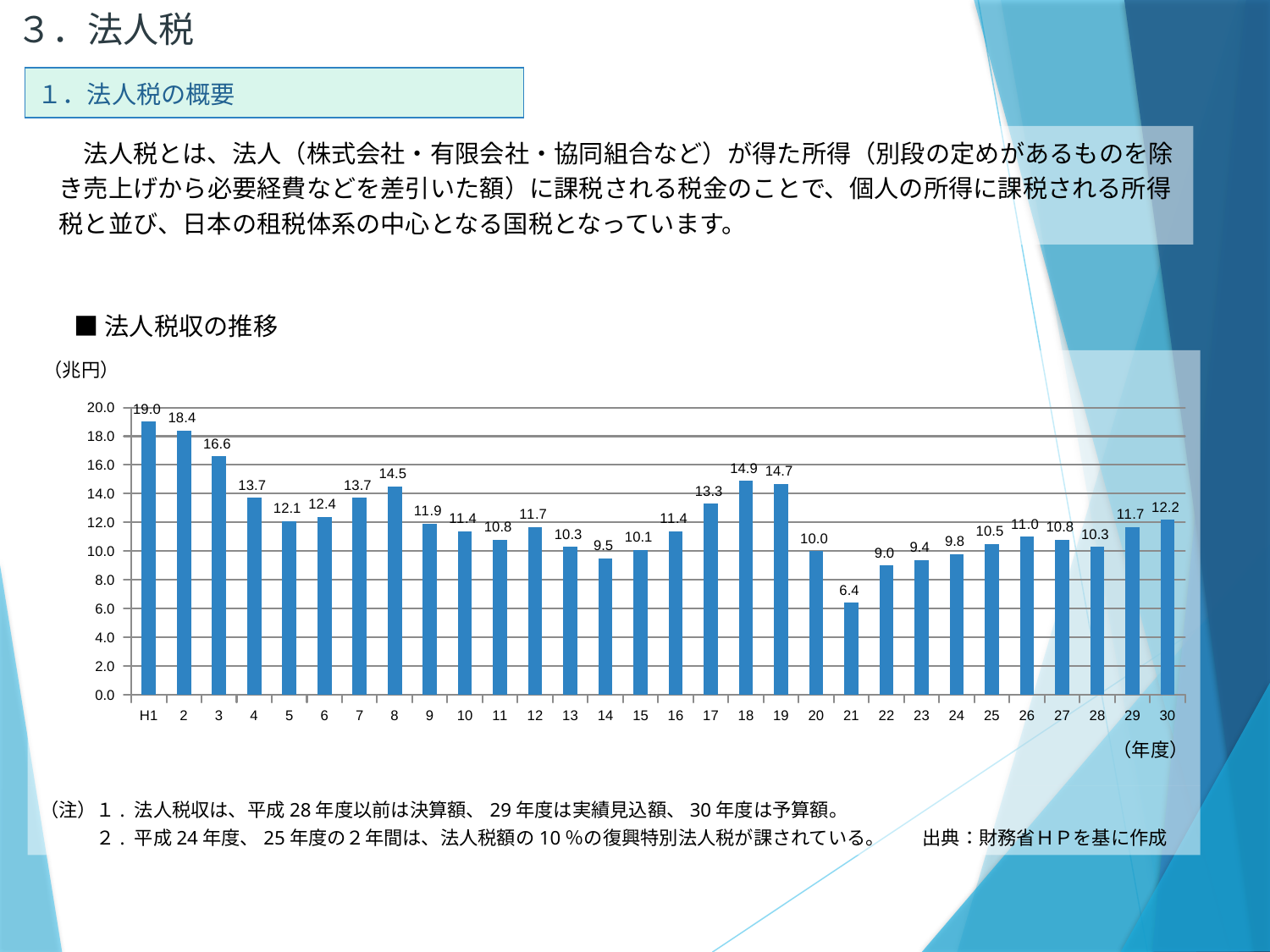
Which fiscal year has the lowest value in the 法人税収の推移 chart? 21 What is the difference between the values for H1 and fiscal year 21 in the 法人税収の推移 chart? 12.6 What is the value for fiscal year 30 in the 法人税収の推移 chart? 12.2 What type of chart is shown under 法人税収の推移? bar chart What unit is indicated for the vertical axis of the 法人税収の推移 chart? 兆円 How many fiscal years (bars) are shown in the 法人税収の推移 chart? 30 What is the value for H1 in the 法人税収の推移 chart? 19.0 What is the difference between the values for fiscal year 19 and fiscal year 20 in the 法人税収の推移 chart? 4.7 Which is larger in the 法人税収の推移 chart, the value for fiscal year 8 or fiscal year 17? fiscal year 8 What is the value for fiscal year 21 in the 法人税収の推移 chart? 6.4 What is the value for fiscal year 18 in the 法人税収の推移 chart? 14.9 Which fiscal year has the highest value in the 法人税収の推移 chart? H1